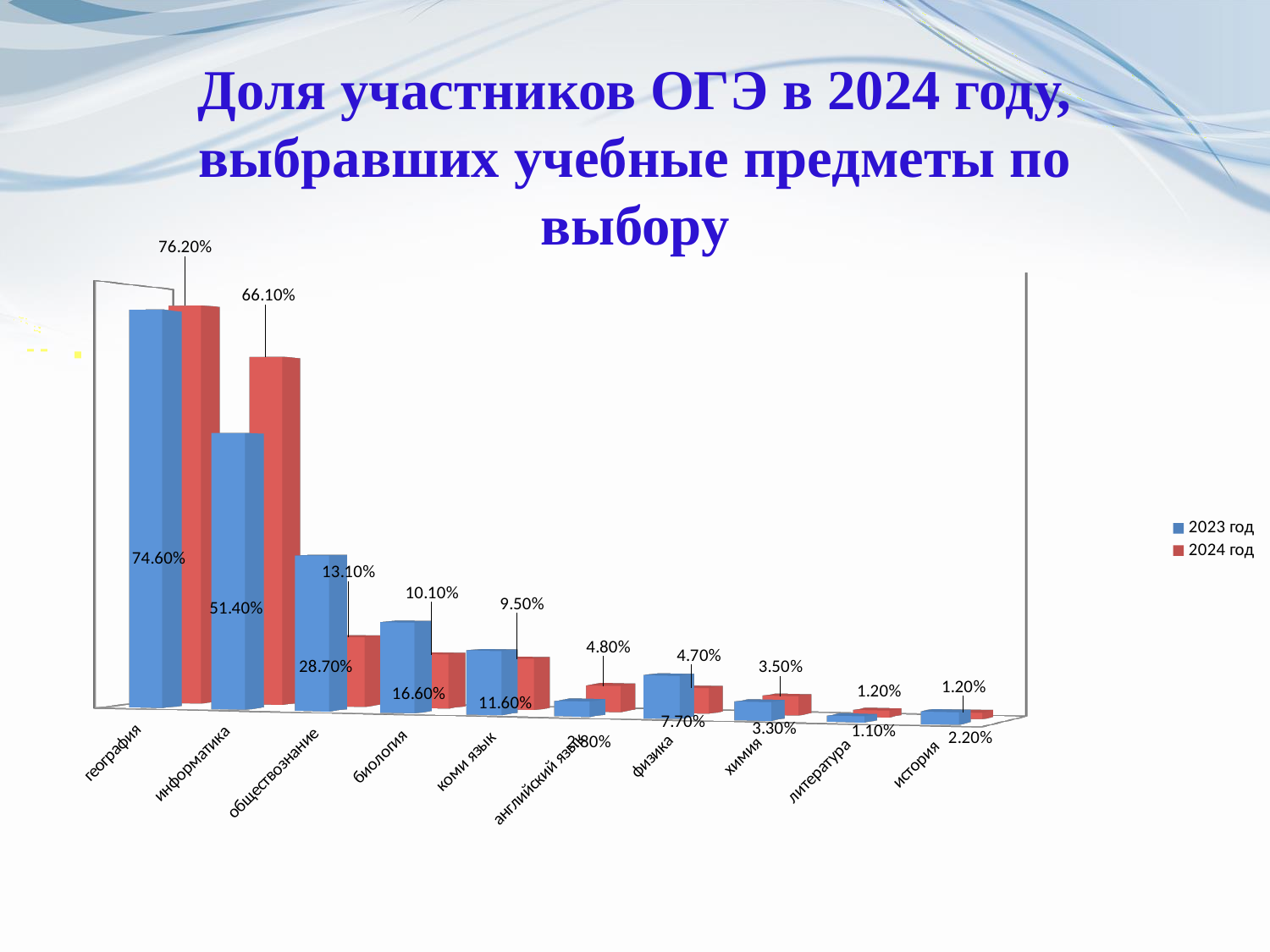
What is the value for информатика in the 2024 год series? 66.10% What is the value for физика in the 2024 год series? 4.70% How many series does the legend list? 2 Which colour represents the 2024 год series in the legend? red What kind of chart is shown on the slide? bar chart For обществознание, which series has the larger value, 2023 год or 2024 год? 2023 год What is the value for обществознание in the 2023 год series? 28.70% What is the value for география in the 2023 год series? 74.60% Which category has the lowest value in the 2023 год series? литература How many categories are shown on the x axis? 10 Which category has the highest value in the 2024 год series? география What is the difference between the 2024 год and 2023 год values for информатика? 14.70%